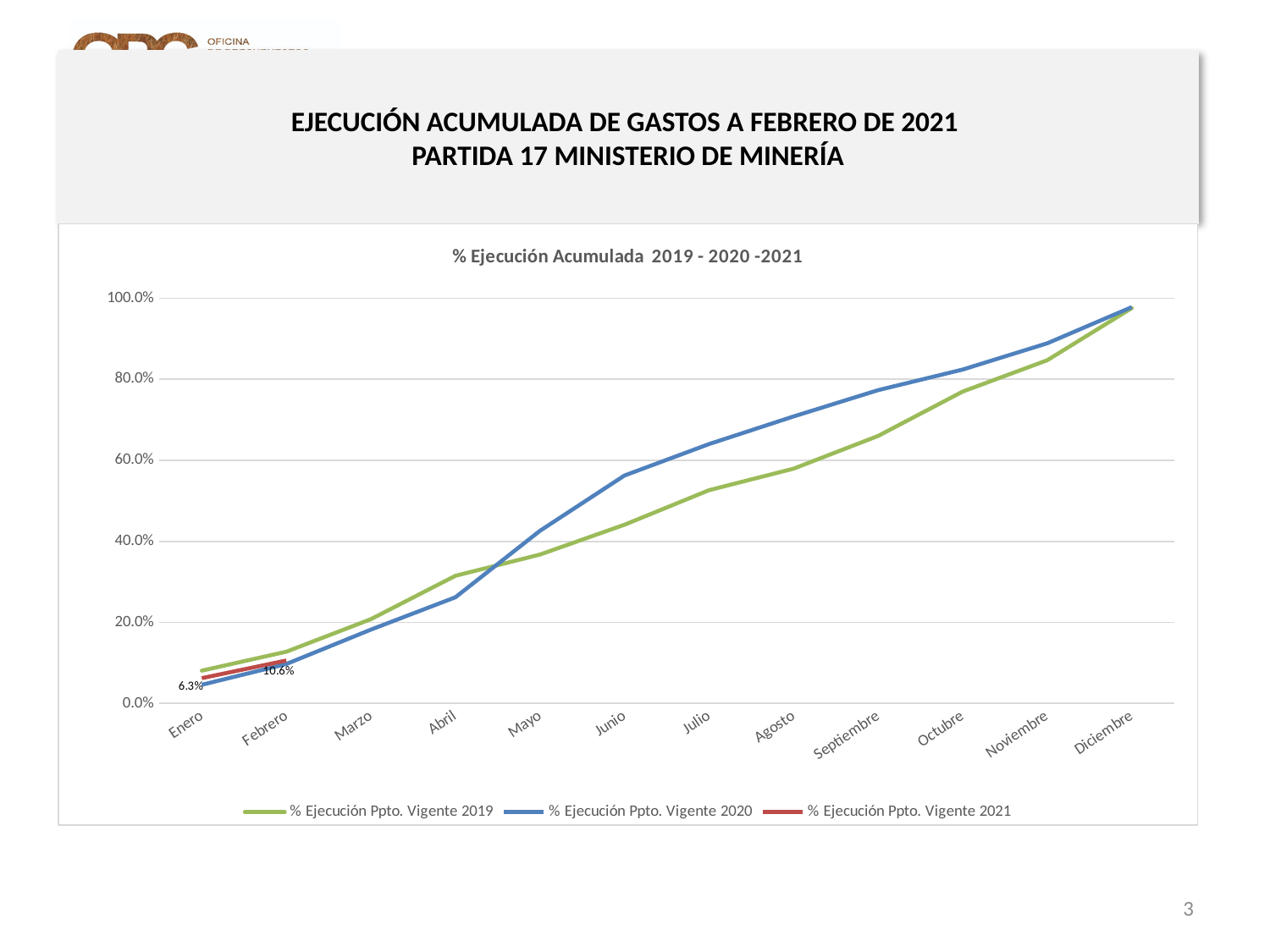
Is the value for % Ejecución Ppto. Vigente 2019 in Abril greater or less than 20.0%? greater What is the value of % Ejecución Ppto. Vigente 2021 for Enero? 6.3% What is the title of the chart? % Ejecución Acumulada 2019 - 2020 -2021 What colour is the line for % Ejecución Ppto. Vigente 2021? Red By how many percentage points did % Ejecución Ppto. Vigente 2021 increase from Enero to Febrero? 4.3 percentage points In Junio, which series has the higher value: % Ejecución Ppto. Vigente 2019 or % Ejecución Ppto. Vigente 2020? % Ejecución Ppto. Vigente 2020 Is the value for % Ejecución Ppto. Vigente 2020 in Junio greater or less than 40.0%? greater How many series does the legend list? 3 Do the values for % Ejecución Ppto. Vigente 2020 rise or fall from Enero to Diciembre? Rise What is the value of % Ejecución Ppto. Vigente 2021 for Febrero? 10.6% What kind of chart is shown on the slide? Line chart How many months are shown on the x axis? 12